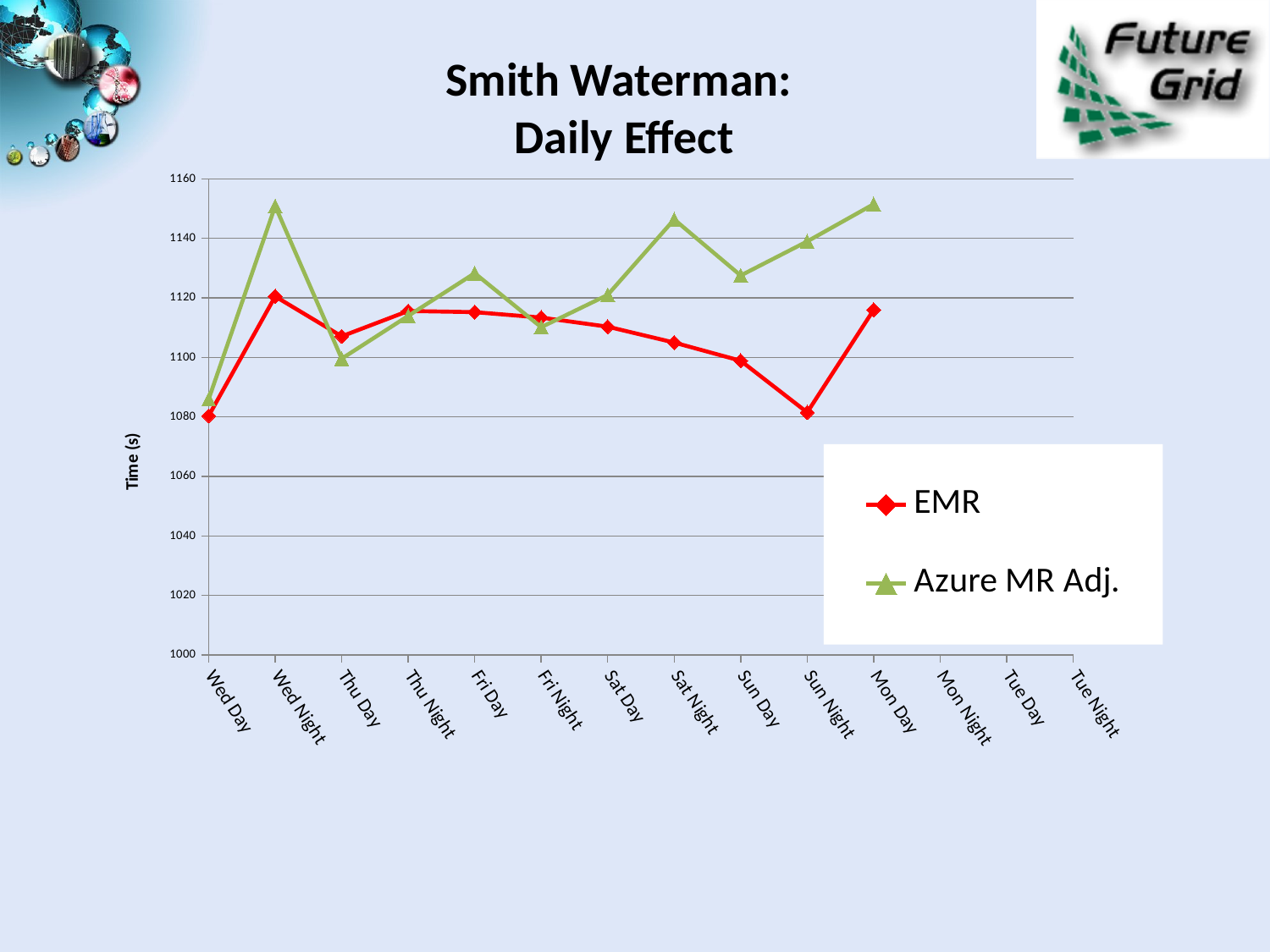
At Sun Night, which series has the higher value, EMR or Azure MR Adj.? Azure MR Adj. Is the Azure MR Adj. value for Fri Day greater or less than 1120? greater What kind of chart is shown on the slide? line chart Does the EMR series rise or fall from Thu Night to Sun Night? fall Is the EMR value for Sun Night greater or less than 1100? less Is the Azure MR Adj. value for Wed Night greater or less than 1140? greater At Wed Night, which series has the higher value, EMR or Azure MR Adj.? Azure MR Adj. What are the two series named in the legend? EMR and Azure MR Adj. How many data points are plotted for the EMR series? 11 How many series does the legend list? 2 What is the label of the vertical axis? Time (s)